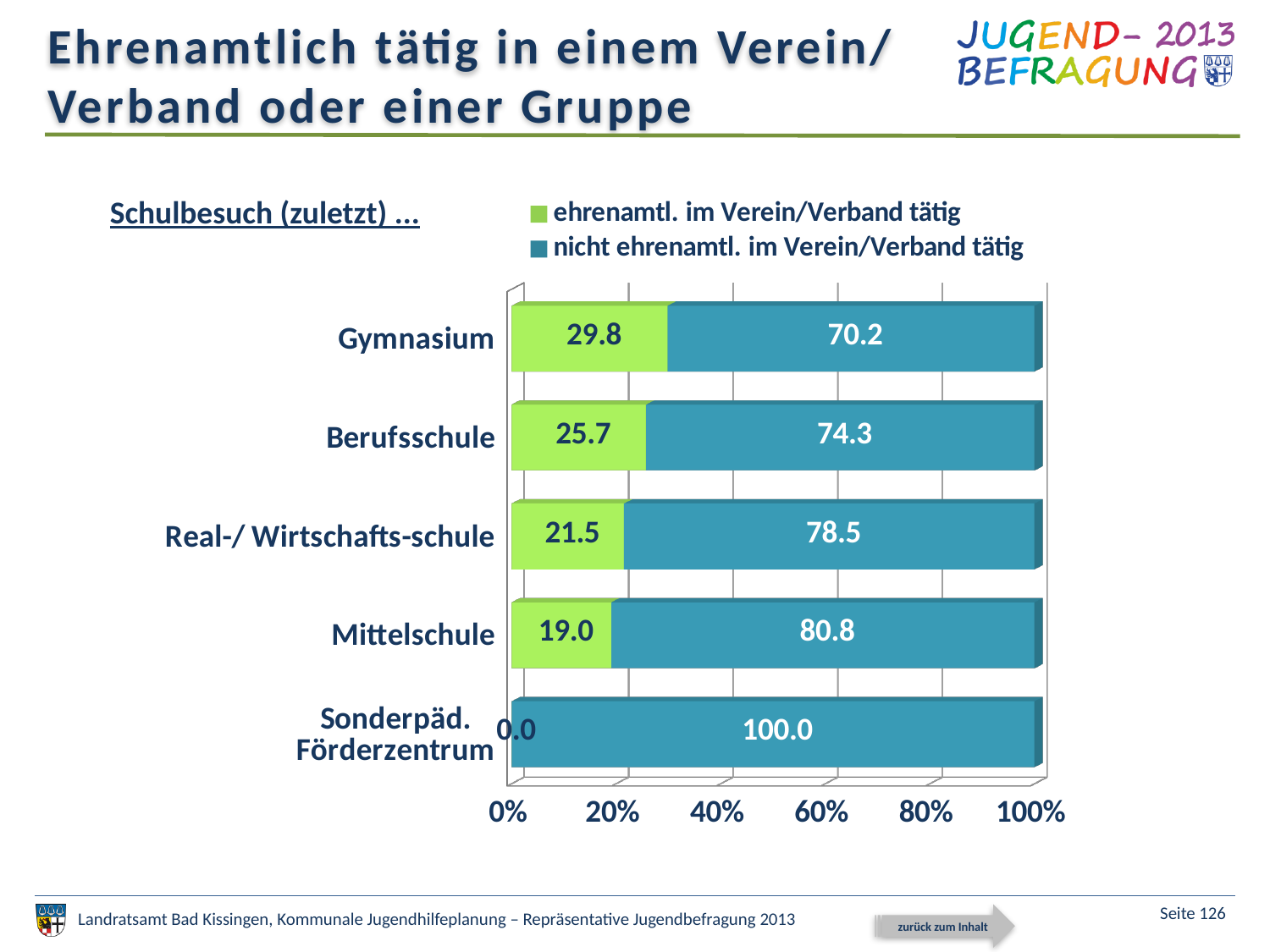
How many series does the legend list? 2 What is the value for 'nicht ehrenamtl. im Verein/Verband tätig' for Sonderpäd. Förderzentrum? 100.0 How many school categories are shown in the chart? 5 What kind of chart is shown on the slide? stacked bar chart What is the value for 'nicht ehrenamtl. im Verein/Verband tätig' for Berufsschule? 74.3 Which is larger: the 'ehrenamtl. im Verein/Verband tätig' value for Berufsschule or for Mittelschule? Berufsschule What is the value for 'ehrenamtl. im Verein/Verband tätig' for Mittelschule? 19.0 What is the value for 'ehrenamtl. im Verein/Verband tätig' for Gymnasium? 29.8 Which school category has the lowest value for 'nicht ehrenamtl. im Verein/Verband tätig'? Gymnasium What is the difference between the 'ehrenamtl. im Verein/Verband tätig' values for Gymnasium and Real-/ Wirtschafts-schule? 8.3 Which school category has the highest value for 'ehrenamtl. im Verein/Verband tätig'? Gymnasium Which colour represents 'nicht ehrenamtl. im Verein/Verband tätig' in the chart? blue